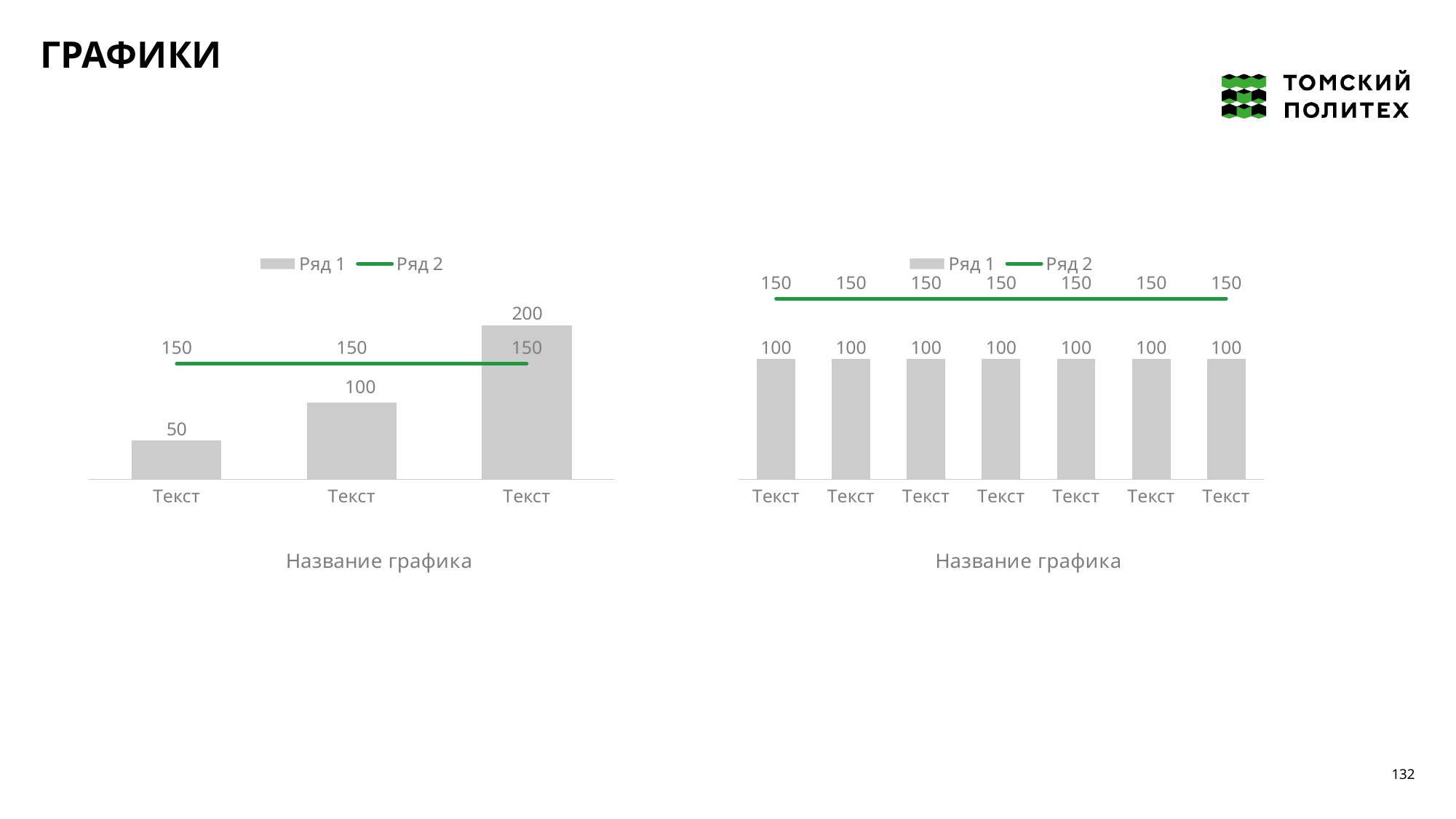
In the left chart, how many series does the legend list? 2 In the left chart, what is the value of the first bar (Ряд 1)? 50 In the left chart, what is the difference between the third bar and the first bar of Ряд 1? 150 In the left chart, which bar of Ряд 1 is the highest: the first, second or third? the third In the left chart, which bar of Ряд 1 is the lowest: the first, second or third? the first In the left chart, do the Ряд 1 bar values rise or fall from left to right? rise In the right chart, what colour is the Ряд 2 line? green In the left chart, what is the value of the third bar (Ряд 1)? 200 In the right chart, which is larger at the first category: Ряд 1 or Ряд 2? Ряд 2 In the right chart, what is the value of each Ряд 1 bar? 100 In the right chart, how many bars are there? 7 In the left chart, what is the value of Ряд 2 at the second category? 150